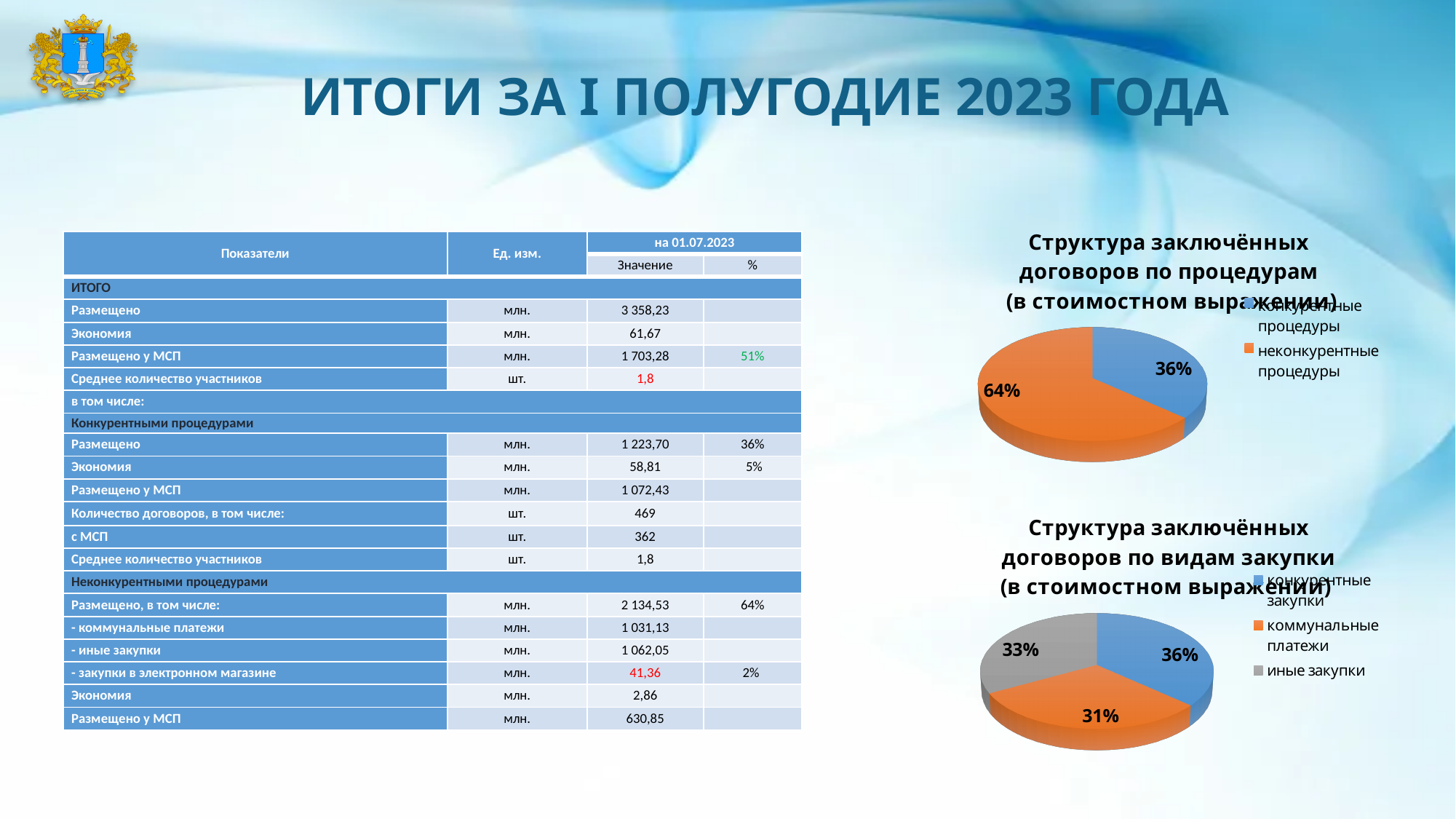
What kind of chart is 'Структура заключённых договоров по процедурам'? Pie chart In the chart 'Структура заключённых договоров по процедурам', what share do 'неконкурентные процедуры' have? 64% In the chart 'Структура заключённых договоров по видам закупки', which colour represents 'иные закупки'? Grey How many categories does the legend of the chart 'Структура заключённых договоров по процедурам' list? 2 In the chart 'Структура заключённых договоров по видам закупки', which category has the smallest slice? коммунальные платежи In the chart 'Структура заключённых договоров по процедурам', what is the difference in percentage points between 'неконкурентные процедуры' and 'конкурентные процедуры'? 28 percentage points In the chart 'Структура заключённых договоров по видам закупки', what share do 'коммунальные платежи' have? 31% In the chart 'Структура заключённых договоров по видам закупки', which category has the largest slice? конкурентные закупки In the chart 'Структура заключённых договоров по видам закупки', what share do 'иные закупки' have? 33% How many slices does the chart 'Структура заключённых договоров по видам закупки' have? 3 In the chart 'Структура заключённых договоров по процедурам', which category has the largest slice? неконкурентные процедуры